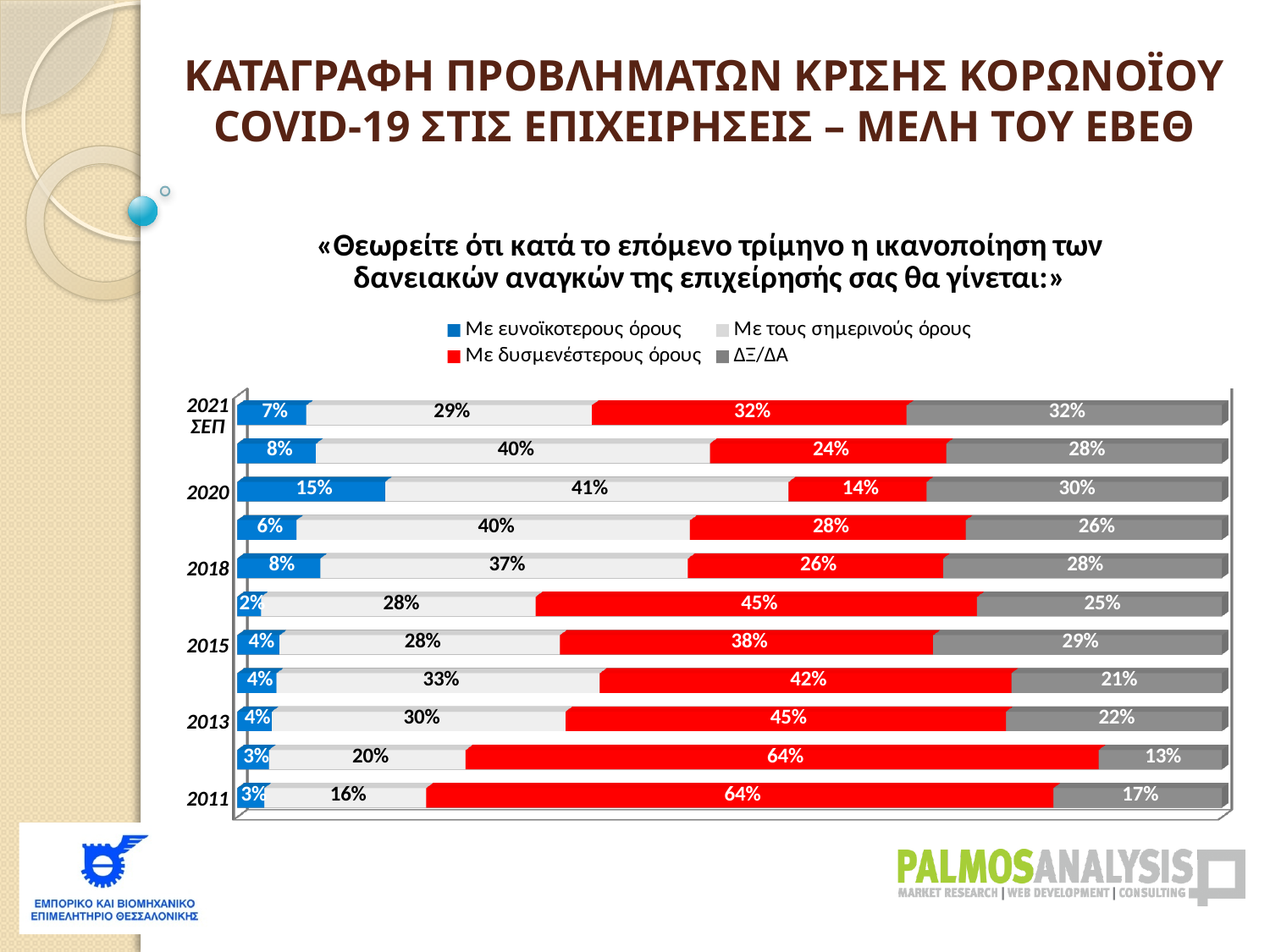
How many series does the legend list? 4 Which series is shown in red in the legend? Με δυσμενέστερους όρους What kind of chart is shown on the slide? stacked bar chart What is the value for 'Με δυσμενέστερους όρους' in 2011? 64% Among the labelled years, which year has the highest value for 'Με ευνοϊκοτερους όρους'? 2020 How many bars are plotted in the chart? 11 Among the labelled years, which year has the lowest value for 'Με τους σημερινούς όρους'? 2011 What is the value for 'Με τους σημερινούς όρους' in 2020? 41% What is the difference between the 'Με δυσμενέστερους όρους' values for 2013 and 2020? 31% What is the value for 'ΔΞ/ΔΑ' in 2015? 29% What is the value for 'Με ευνοϊκοτερους όρους' in 2021 ΣΕΠ? 7% Which is larger: the 'ΔΞ/ΔΑ' value for 2021 ΣΕΠ or for 2013? 2021 ΣΕΠ